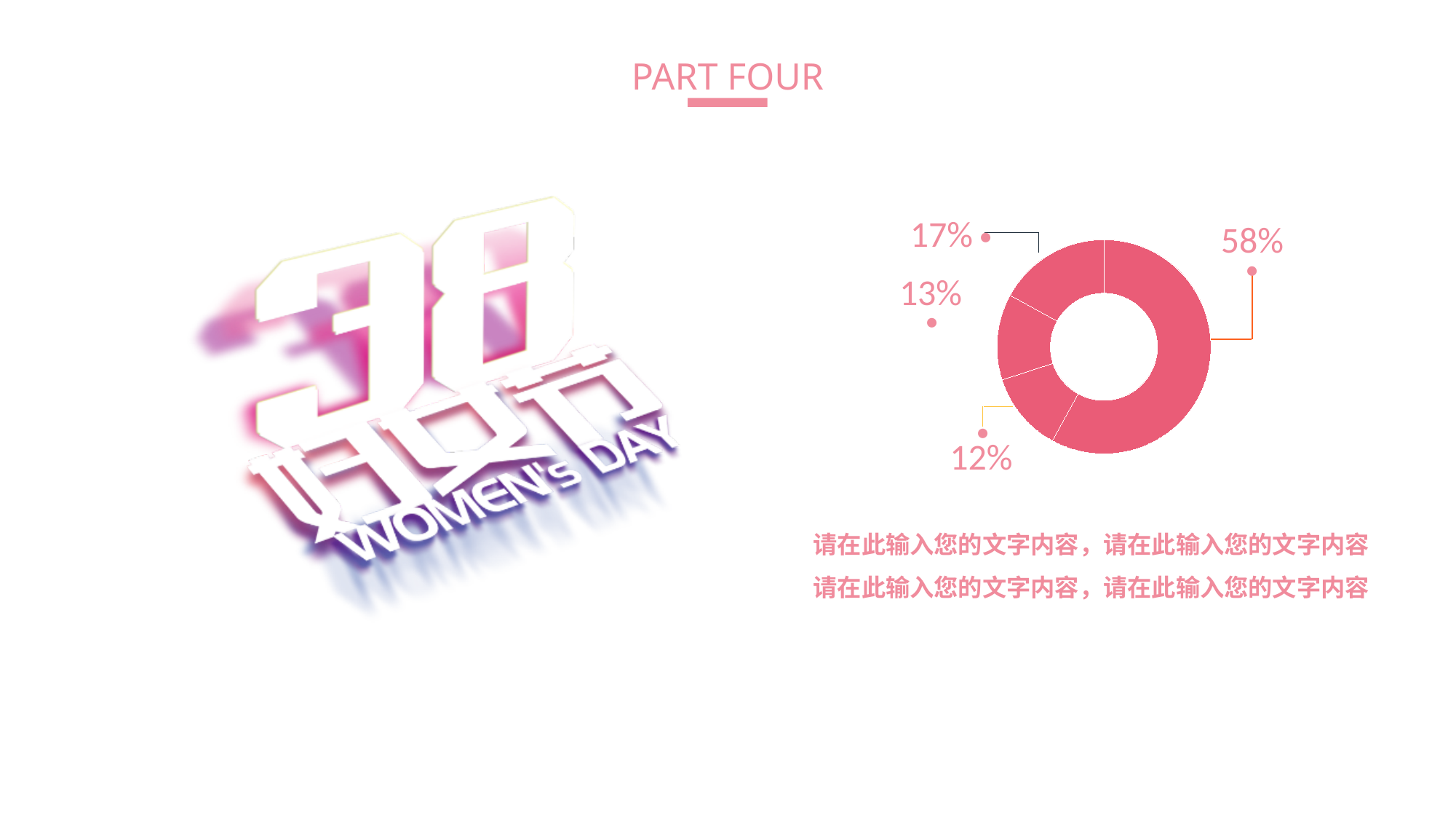
What is the largest percentage shown on the doughnut chart? 58% What share of the doughnut chart does the largest slice take? 58% What is the difference between the largest and smallest slices of the doughnut chart? 46% Is the largest slice of the doughnut chart greater or less than 50%? greater What kind of chart is shown on the right side of the slide? doughnut chart Which is larger, the slice labelled 17% or the slice labelled 12%? 17% What colour are the slices of the doughnut chart? pink How many slices does the doughnut chart have? 4 What is the heading text at the top of the slide? PART FOUR What do the four percentages on the doughnut chart add up to? 100% What is the difference between the 17% slice and the 13% slice? 4% What is the smallest percentage shown on the doughnut chart? 12%